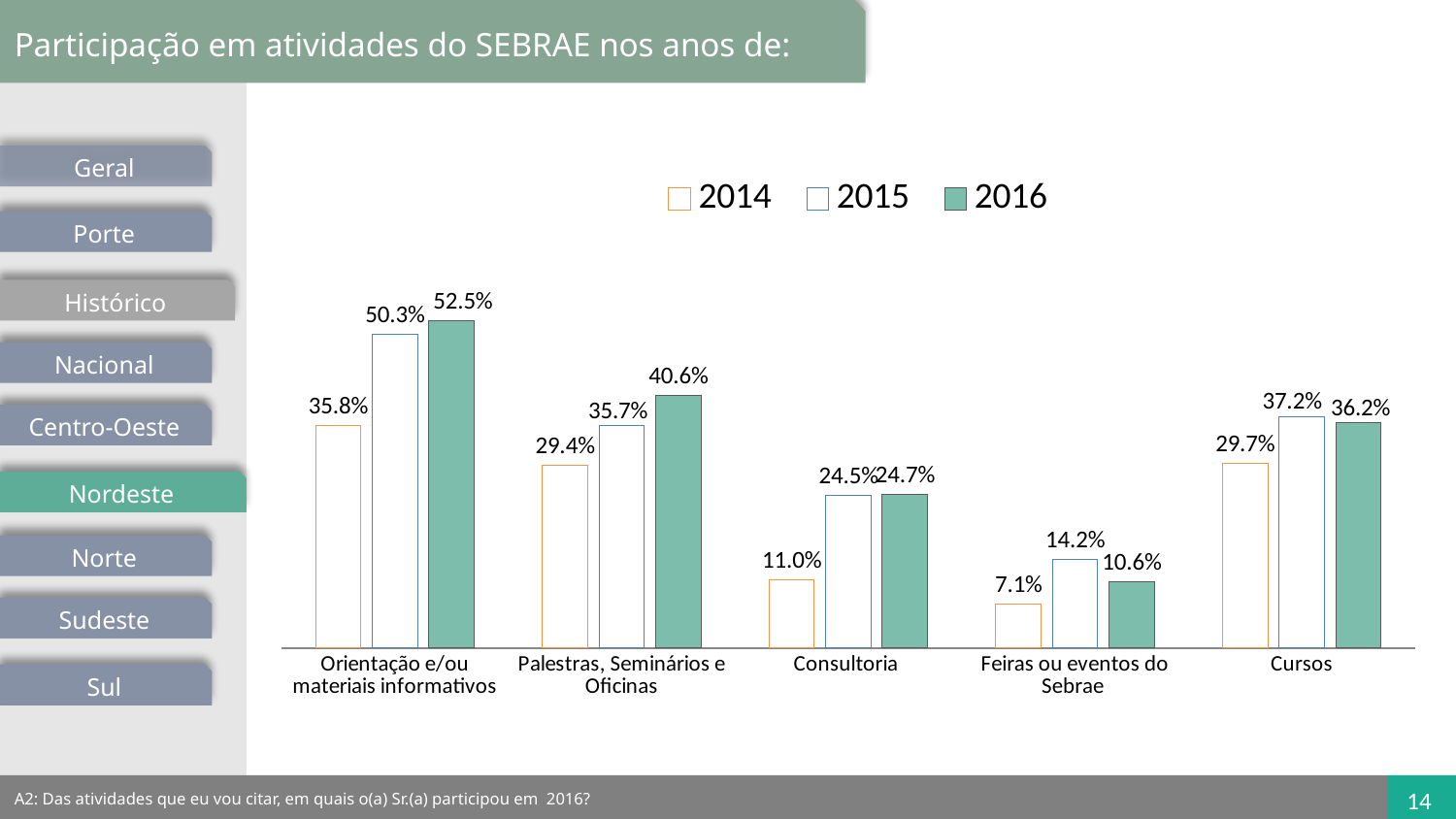
In the "Cursos" category, which year has the larger value, 2015 or 2016? 2015 What kind of chart is shown on the slide? Bar chart What is the value for 2014 in the "Consultoria" category? 11.0% How many series does the legend list? 3 Which category has the lowest value for the 2014 series? Feiras ou eventos do Sebrae How many categories are shown on the x axis of the chart? 5 What is the value for 2015 in the "Feiras ou eventos do Sebrae" category? 14.2% What is the value for 2016 in the "Orientação e/ou materiais informativos" category? 52.5% What is the difference between the 2016 and 2014 values for "Palestras, Seminários e Oficinas"? 11.2% Which category has the highest value for the 2016 series? Orientação e/ou materiais informativos In the "Feiras ou eventos do Sebrae" category, which year has the larger value, 2015 or 2016? 2015 What is the difference between the 2015 and 2014 values for "Orientação e/ou materiais informativos"? 14.5%